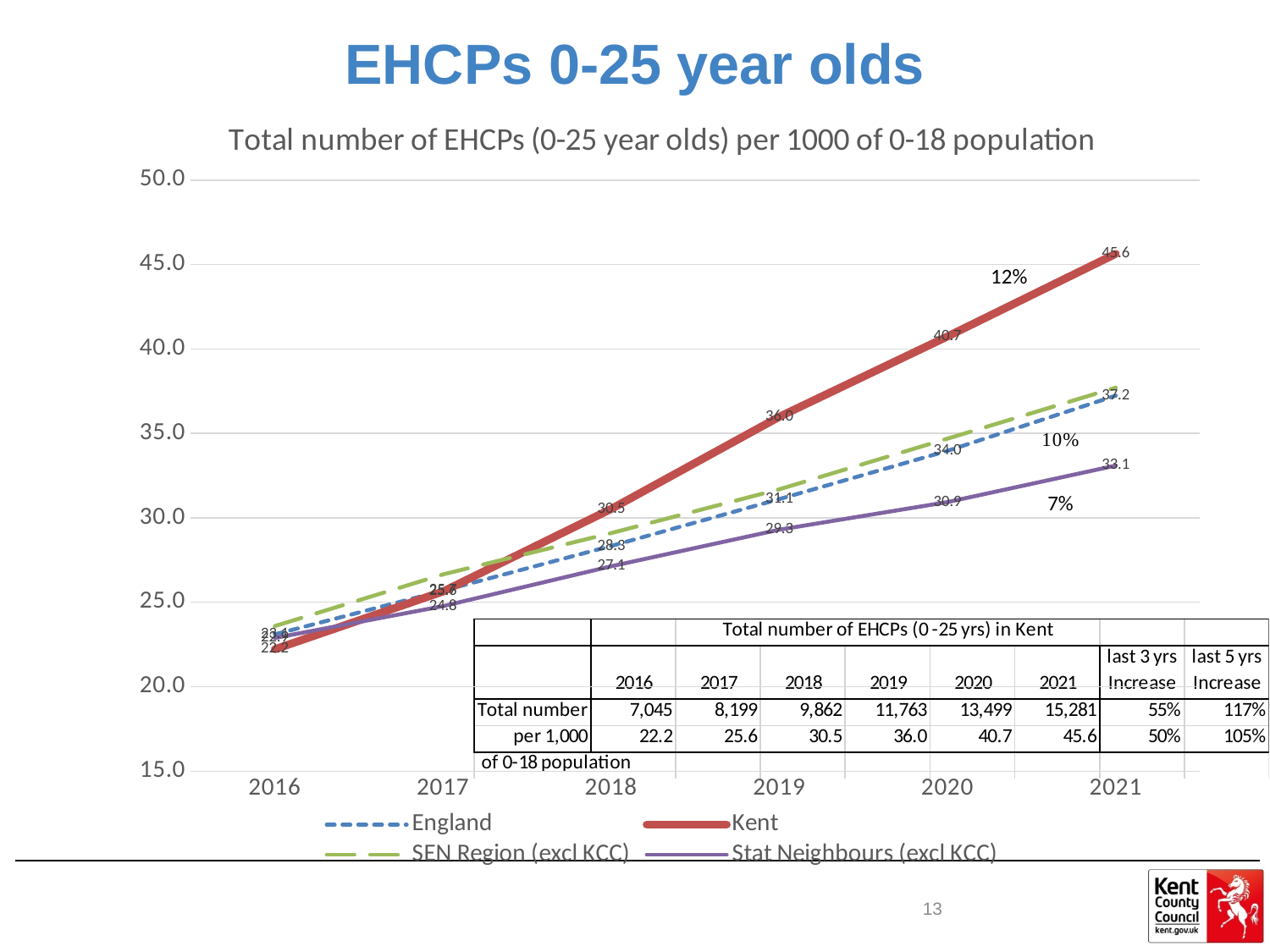
How many series does the chart legend list? 4 By how much did the Kent value per 1000 increase from 2016 to 2021? 23.4 What type of chart is shown on the slide? line chart What is the title of the chart? Total number of EHCPs (0-25 year olds) per 1000 of 0-18 population What is the Kent value per 1000 of 0-18 population in 2016? 22.2 What is the Kent value per 1000 of 0-18 population in 2021? 45.6 Is the Kent value in 2020 greater or less than 40.0? greater Which series has the lowest value in 2021? Stat Neighbours (excl KCC) Does the Kent line rise or fall from 2016 to 2021? rise Which series has the highest value in 2021? Kent How many years are plotted along the x axis of the chart? 6 What is the Kent value per 1000 of 0-18 population in 2019? 36.0